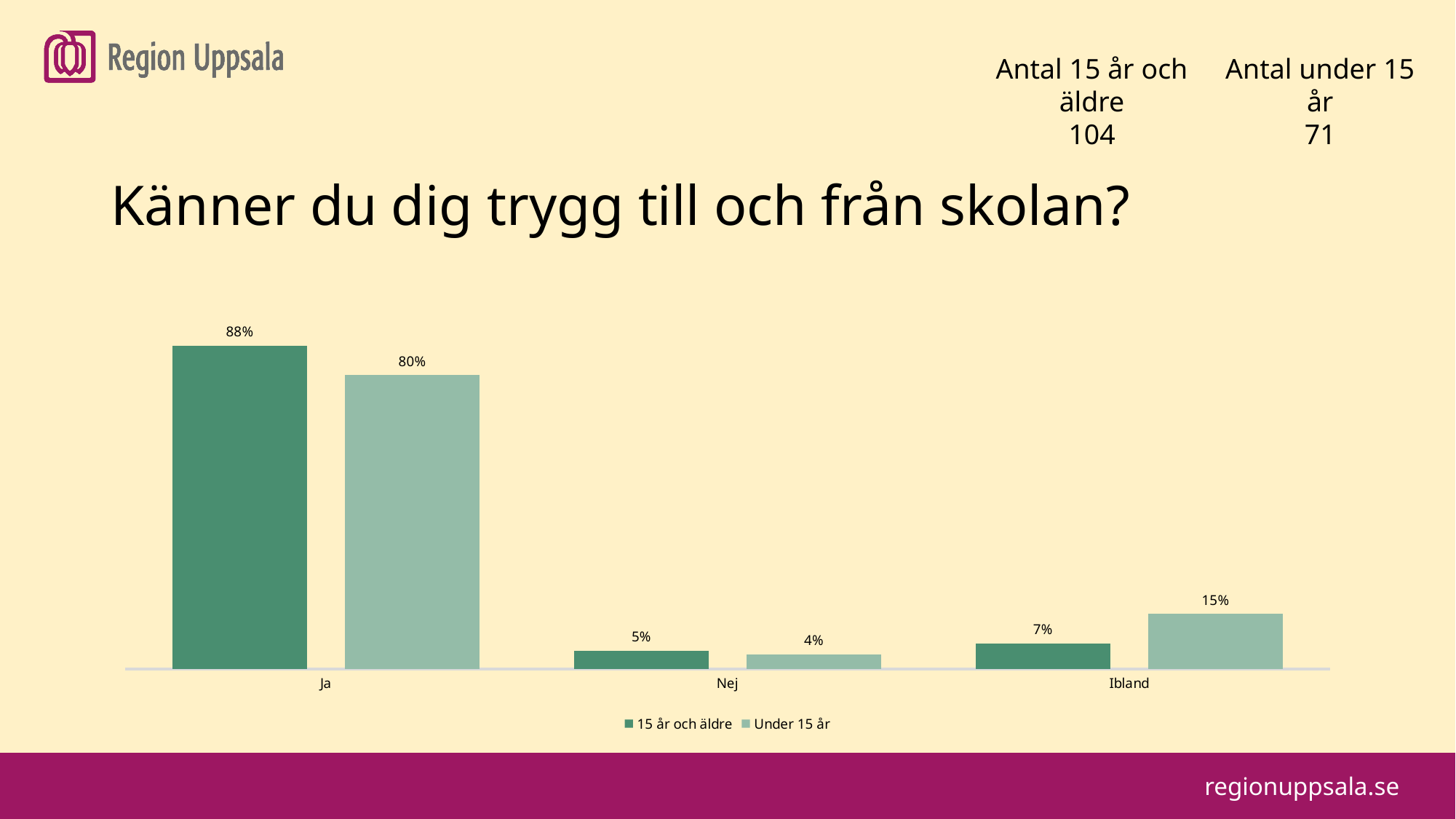
How many answer categories are shown on the x axis? 3 Which answer category has the lowest value for the Under 15 år series? Nej What percentage of respondents Under 15 år answered Nej? 4% What are the two series named in the legend? 15 år och äldre and Under 15 år Which answer category has the highest value for the 15 år och äldre series? Ja How many series does the legend list? 2 What is the difference between the Ja values for 15 år och äldre and Under 15 år? 8 percentage points For the Ibland category, which series has the larger value: 15 år och äldre or Under 15 år? Under 15 år What percentage of respondents Under 15 år answered Ibland? 15% What kind of chart is shown on the slide? Bar chart What is the difference between the Ibland values for Under 15 år and 15 år och äldre? 8 percentage points What percentage of respondents aged 15 år och äldre answered Ja? 88%